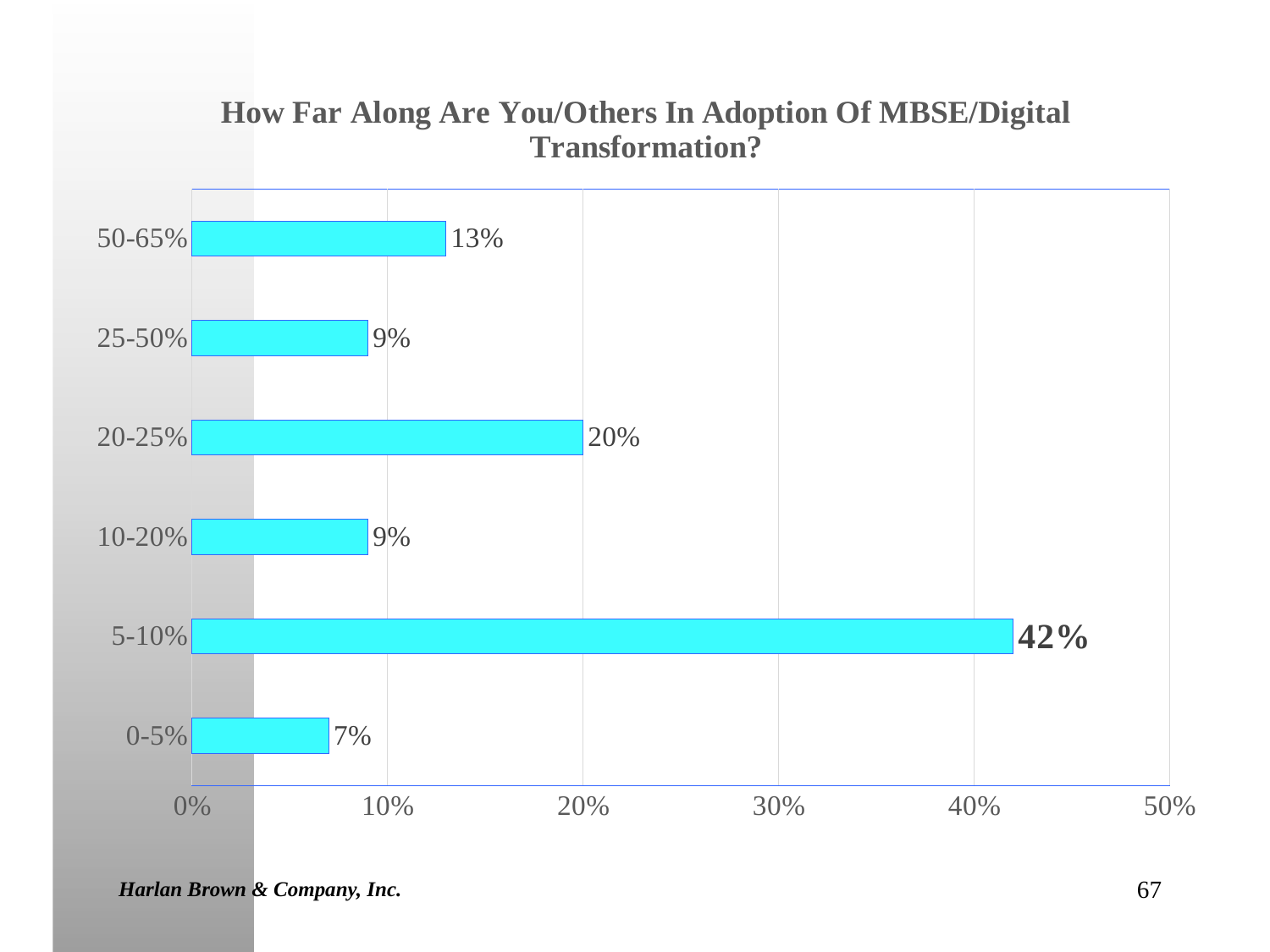
What is the value for the 5-10% category? 42% What is the value for the 0-5% category? 7% What is the value for the 20-25% category? 20% What is the value for the 50-65% category? 13% How many categories are shown in the chart? 6 Which category has the lowest value? 0-5% Which is larger, the value for 50-65% or the value for 0-5%? 50-65% What is the difference between the values for 50-65% and 25-50%? 4% What is the difference between the values for 5-10% and 20-25%? 22% Which category has the highest value? 5-10% What kind of chart is shown on the slide? Bar chart What is the title of the chart? How Far Along Are You/Others In Adoption Of MBSE/Digital Transformation?